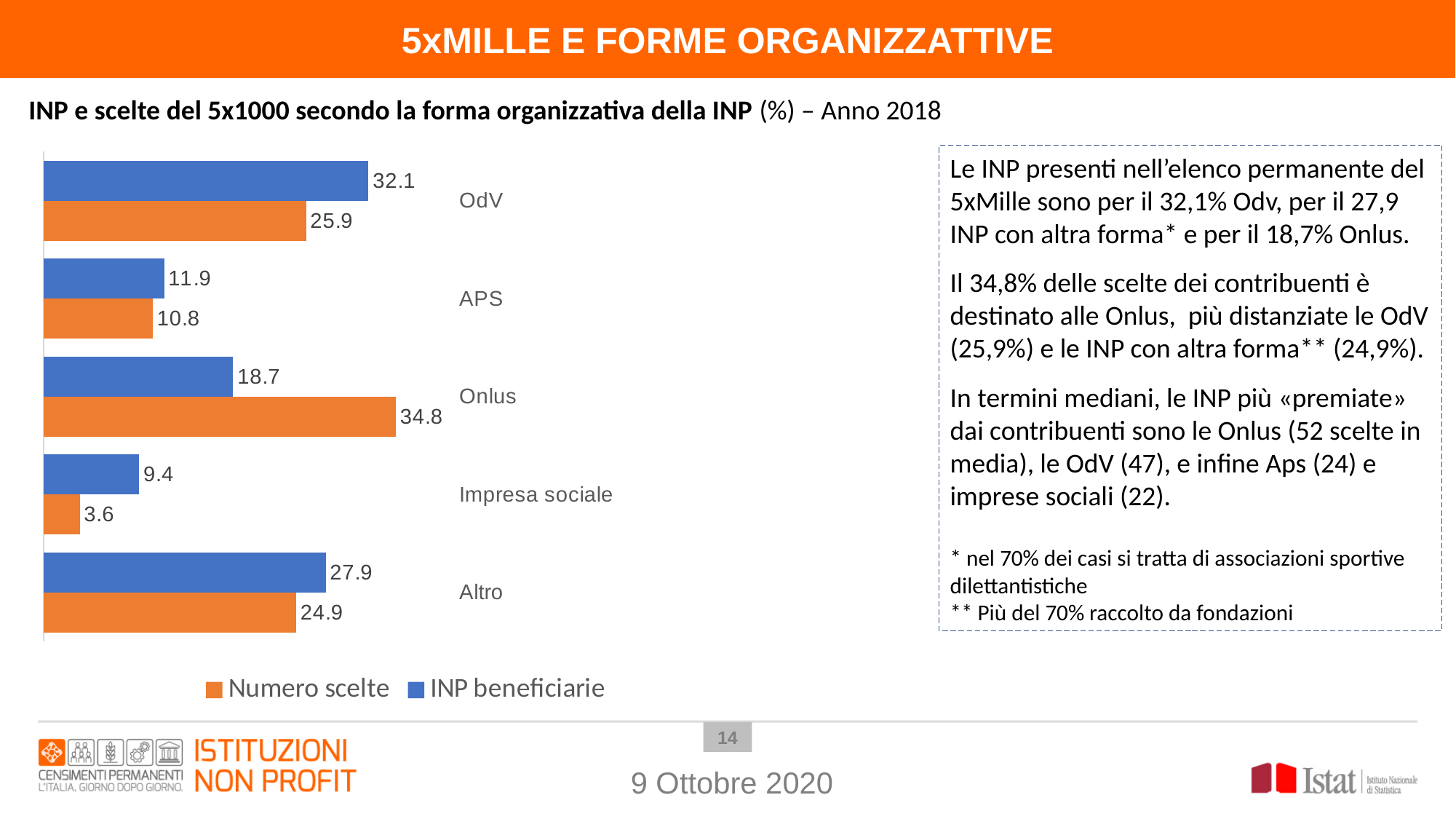
What is the value of Numero scelte for Impresa sociale? 3.6 What is the difference between INP beneficiarie and Numero scelte for Onlus? 16.1 Which is larger for APS: Numero scelte or INP beneficiarie? INP beneficiarie How many categories are shown in the chart? 5 Which category has the lowest value for INP beneficiarie? Impresa sociale How many series does the legend list? 2 What is the difference between INP beneficiarie and Numero scelte for OdV? 6.2 What kind of chart is shown on the slide? Bar chart What is the value of INP beneficiarie for OdV? 32.1 What is the value of INP beneficiarie for Altro? 27.9 What is the value of Numero scelte for Onlus? 34.8 Which category has the highest value for Numero scelte? Onlus